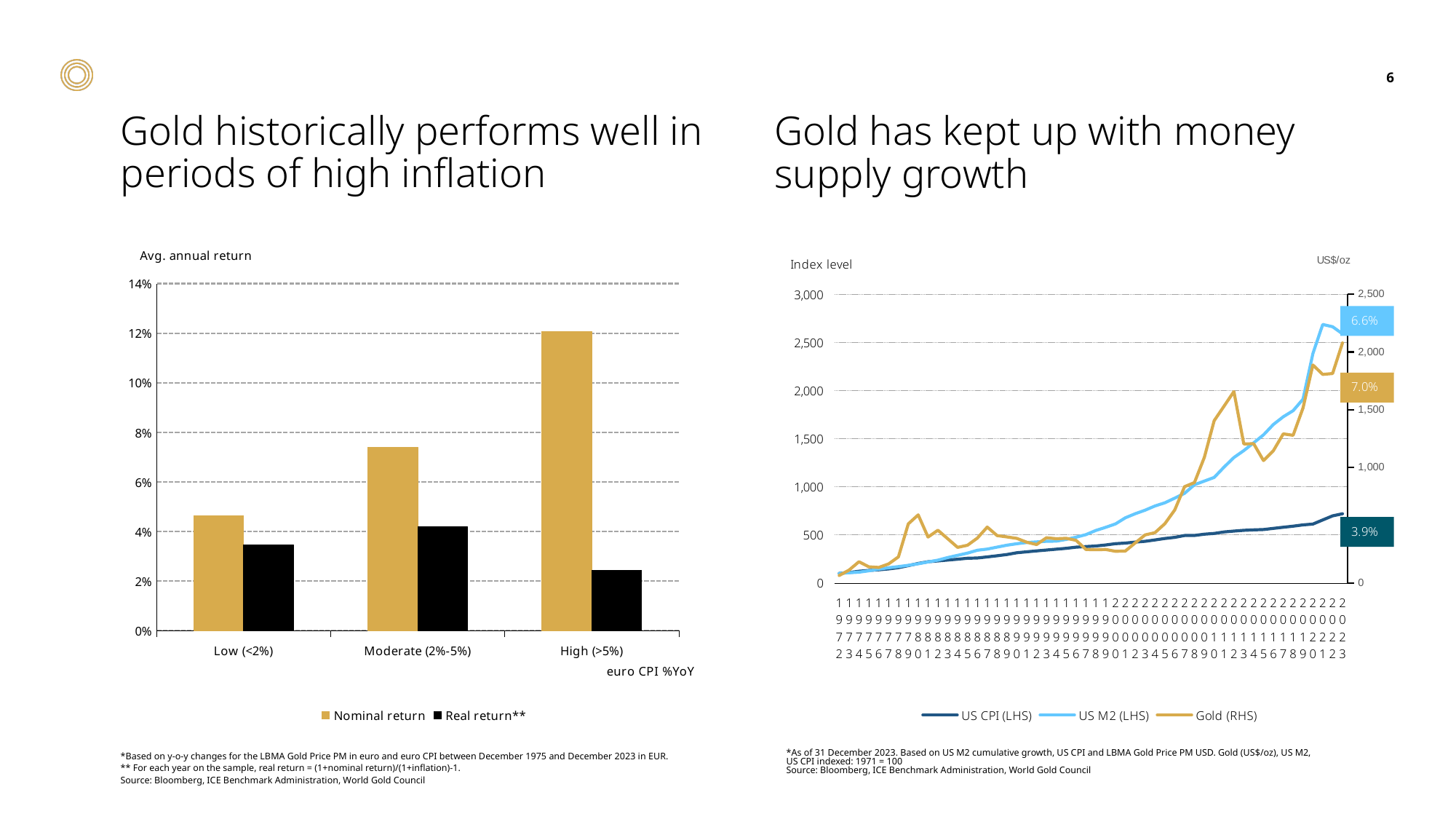
In the left chart, is the nominal return for High (>5%) greater or less than 10%? greater In the right chart, how many series does the legend list? 3 In the left chart, how many inflation categories are shown on the x axis? 3 In the right chart, what percentage label is shown next to the Gold (RHS) line? 7.0% What kind of chart is the right chart, 'Gold has kept up with money supply growth'? line chart In the left chart, which inflation category has the lowest real return? High (>5%) What kind of chart is the left chart, 'Gold historically performs well in periods of high inflation'? bar chart In the left chart, is the real return for High (>5%) greater or less than 4%? less In the left chart, for the Low (<2%) category, which is larger: the nominal return or the real return? Nominal return In the left chart, which inflation category has the highest nominal return? High (>5%) In the left chart, how many series does the legend list? 2 In the left chart, is the nominal return for Moderate (2%-5%) greater or less than 6%? greater